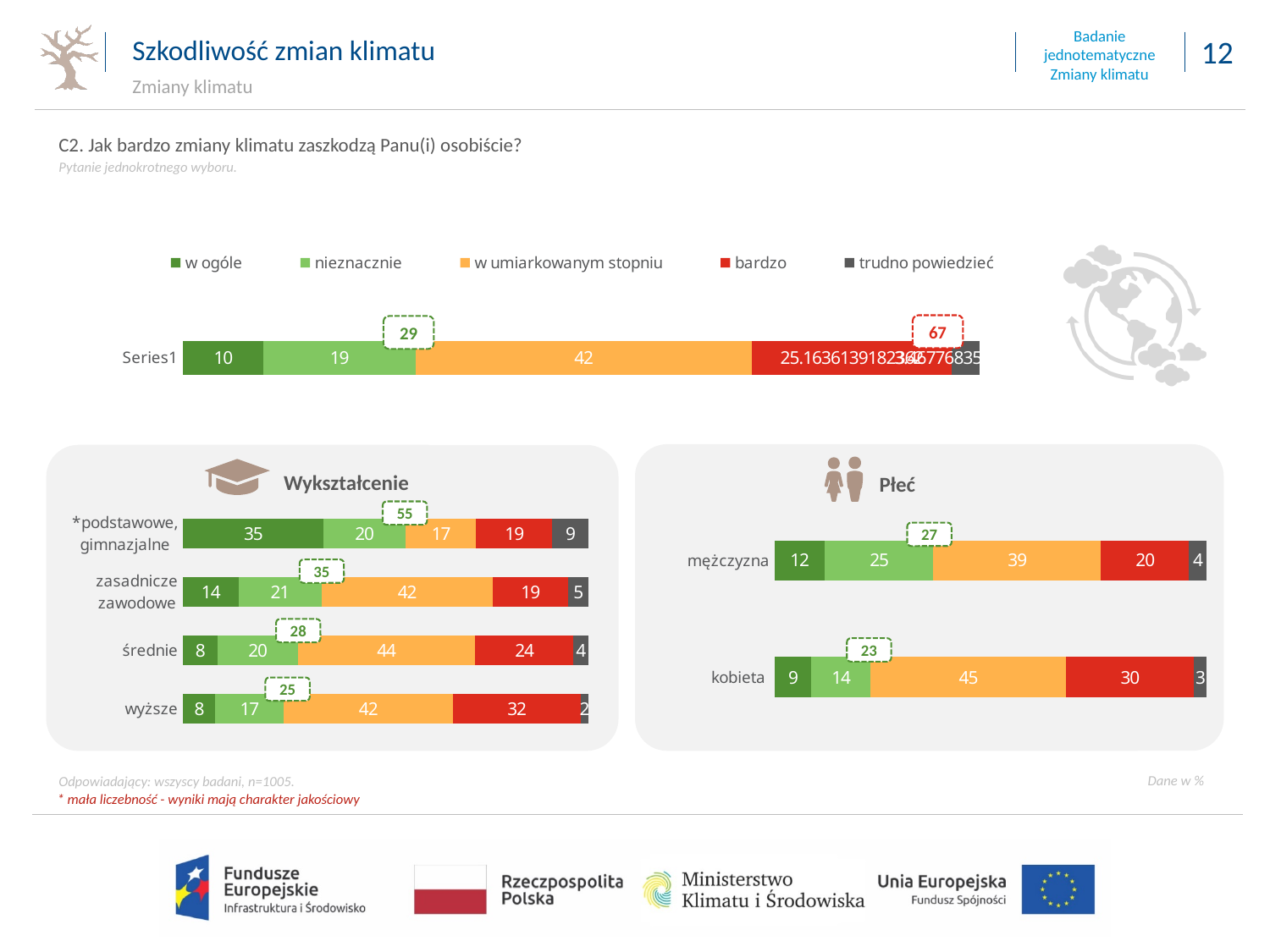
In the Wykształcenie chart, which is larger: 'nieznacznie' for 'zasadnicze zawodowe' or 'nieznacznie' for 'wyższe'? zasadnicze zawodowe In the top chart, what is the value of 'w umiarkowanym stopniu' for Series1? 42 How many series does the legend at the top of the slide list? 5 In the Płeć chart, what is the value of 'nieznacznie' for 'mężczyzna'? 25 In the Płeć chart, what is the value of 'w umiarkowanym stopniu' for 'kobieta'? 45 In the Wykształcenie chart, how many education categories are shown? 4 In the Płeć chart, which group has the lower value for 'bardzo'? mężczyzna In the Wykształcenie chart, what is the value of 'bardzo' for 'wyższe'? 32 In the Wykształcenie chart, what is the value of 'w umiarkowanym stopniu' for 'średnie'? 44 In the Wykształcenie chart, which education group has the highest value for 'w ogóle'? *podstawowe, gimnazjalne What type of chart is the Płeć chart? stacked bar chart In the Płeć chart, what is the difference between the 'bardzo' values for 'kobieta' and 'mężczyzna'? 10